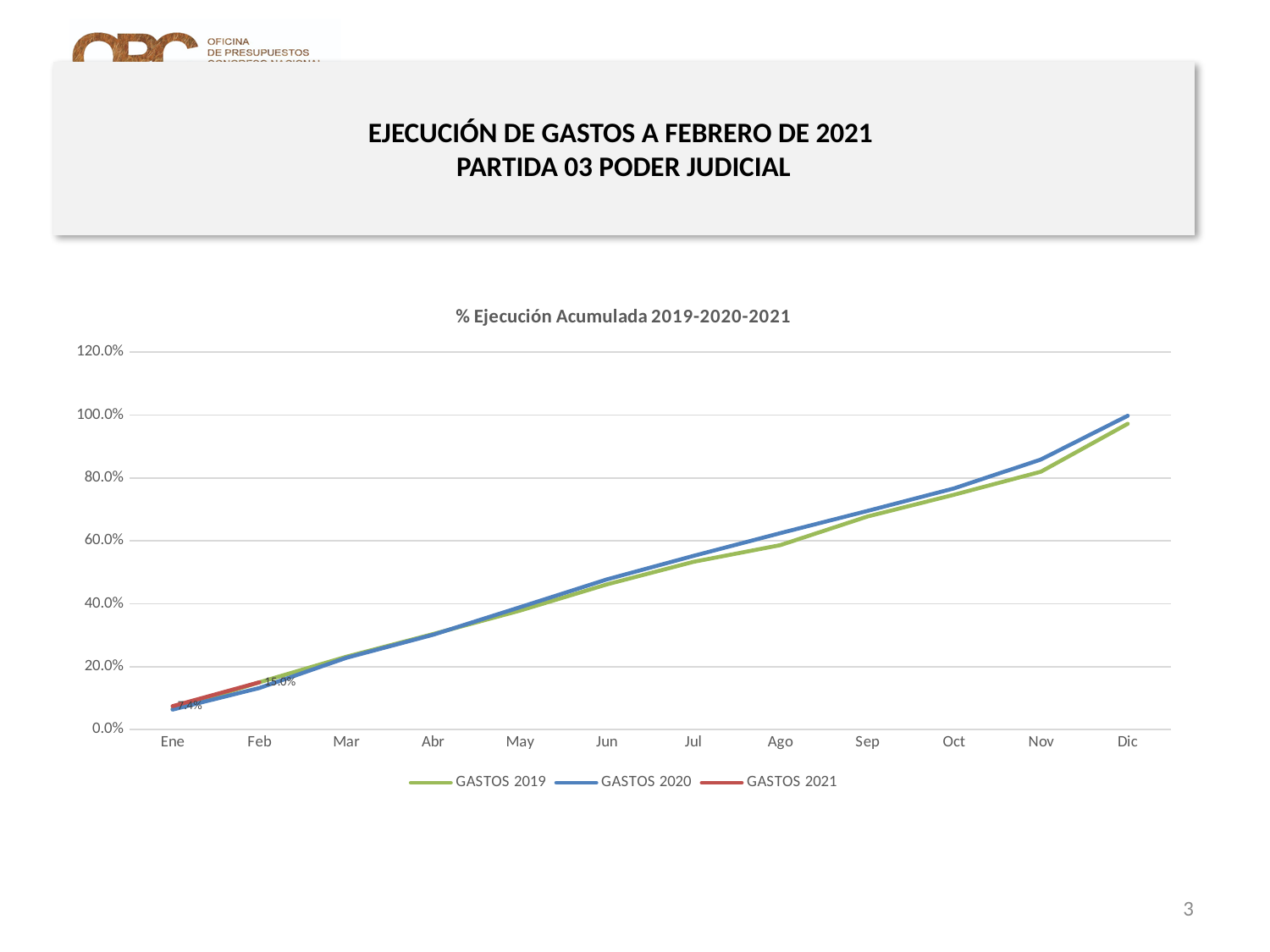
What is the difference between the GASTOS 2021 values for Feb and Ene? 7.6% What is the value for GASTOS 2021 in Ene? 7.4% In Dic, which series has the higher value, GASTOS 2019 or GASTOS 2020? GASTOS 2020 What is the title of the chart? % Ejecución Acumulada 2019-2020-2021 What kind of chart is shown on the slide? line chart In which month does GASTOS 2020 reach its highest value? Dic How many series does the legend list? 3 Is the value for GASTOS 2019 in Mar greater or less than 40.0%? less Is the value for GASTOS 2020 in Dic greater or less than 80.0%? greater How many months are shown along the x axis? 12 What is the value for GASTOS 2021 in Feb? 15.0% Do the GASTOS 2020 values rise or fall from Ene to Dic? rise